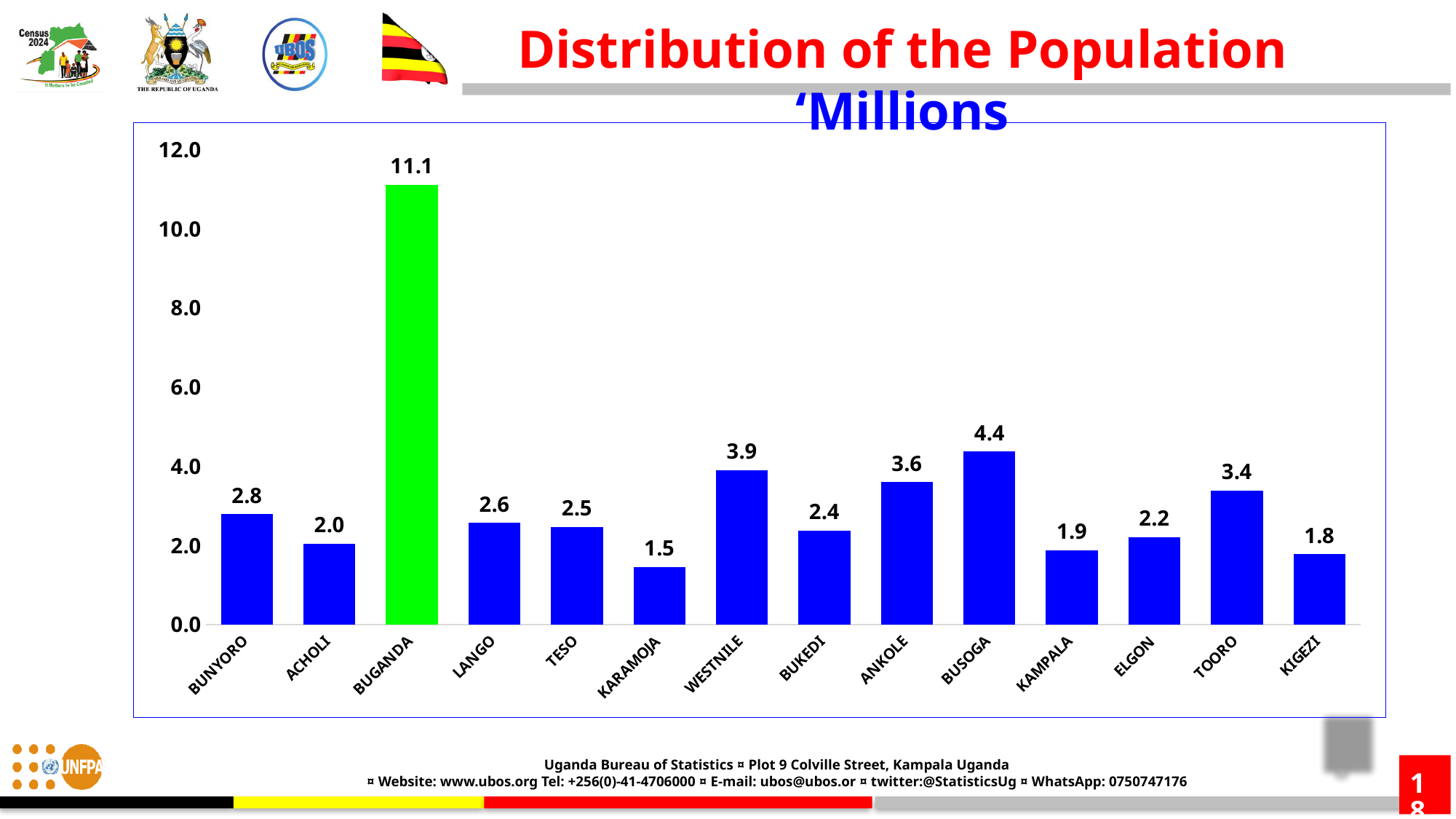
How many regions are shown on the x axis of the chart? 14 Which region has the lowest population in the chart? KARAMOJA What is the population value shown for KARAMOJA? 1.5 What is the population value shown for BUSOGA? 4.4 What is the difference between the values for BUNYORO and ACHOLI? 0.8 What is the population value shown for BUGANDA? 11.1 Is the value for TOORO greater or less than 4.0? less Which bar is coloured green rather than blue? BUGANDA Which has a larger value, WESTNILE or ANKOLE? WESTNILE Which region has the highest population in the chart? BUGANDA What kind of chart is shown on the slide? bar chart What is the difference between the values for BUGANDA and BUSOGA? 6.7